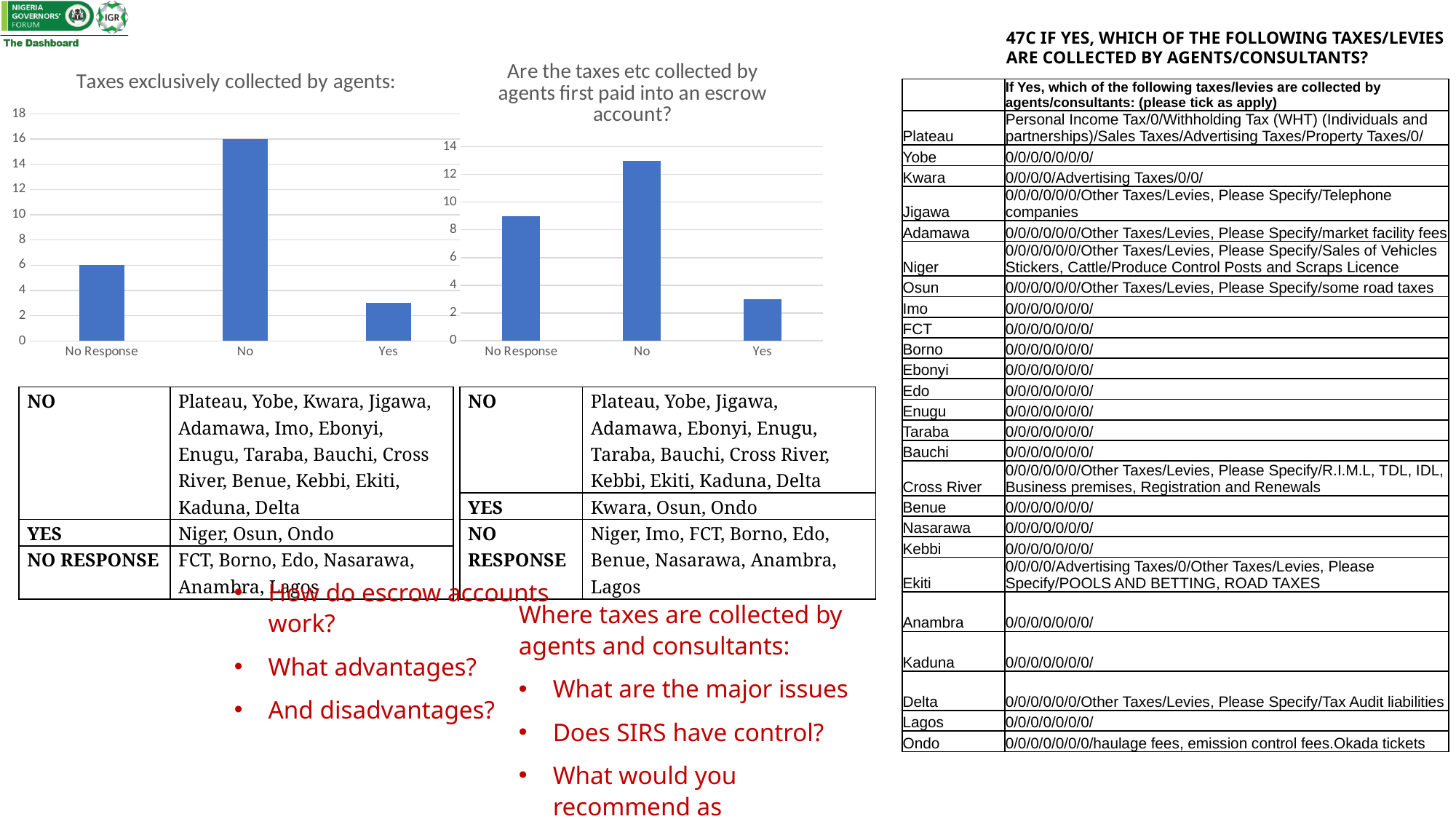
In the chart titled "Are the taxes etc collected by agents first paid into an escrow account?", how many categories are shown on the x axis? 3 In the chart titled "Taxes exclusively collected by agents:", which category has the highest value? No In the chart titled "Taxes exclusively collected by agents:", what is the value for "No Response"? 6 In the chart titled "Are the taxes etc collected by agents first paid into an escrow account?", which category has the highest value? No In the chart titled "Taxes exclusively collected by agents:", what is the value for "No"? 16 What type of chart is the chart titled "Taxes exclusively collected by agents:"? bar chart In the chart titled "Are the taxes etc collected by agents first paid into an escrow account?", is the value for "No" greater or less than 12? greater In the chart titled "Are the taxes etc collected by agents first paid into an escrow account?", is the value for "No Response" greater or less than 8? greater In the chart titled "Taxes exclusively collected by agents:", which category has the lowest value? Yes In the chart titled "Taxes exclusively collected by agents:", is the value for "Yes" greater or less than 4? less In the chart titled "Taxes exclusively collected by agents:", what is the difference between the values for "No" and "No Response"? 10 In the chart titled "Are the taxes etc collected by agents first paid into an escrow account?", which category has the lowest value? Yes